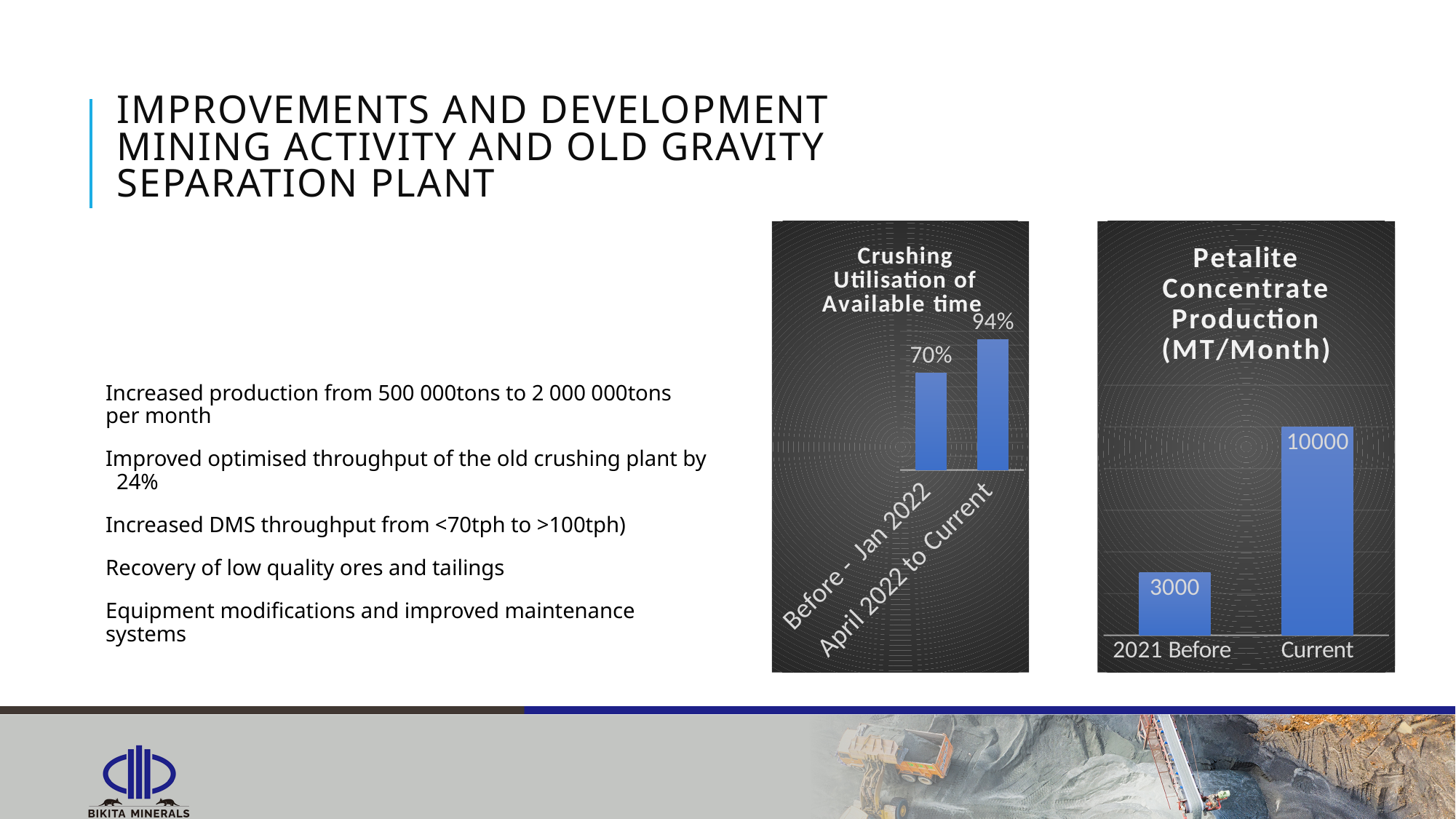
In the 'Petalite Concentrate Production (MT/Month)' chart, what is the difference between the 'Current' and '2021 Before' values? 7000 In the 'Petalite Concentrate Production (MT/Month)' chart, is the value for 'Current' larger or smaller than the value for '2021 Before'? larger What kind of chart is the 'Petalite Concentrate Production (MT/Month)' chart? bar chart In the 'Crushing Utilisation of Available time' chart, what is the value for 'April 2022 to Current'? 94% In the 'Crushing Utilisation of Available time' chart, which category has the higher value? April 2022 to Current In the 'Petalite Concentrate Production (MT/Month)' chart, which category has the lowest value? 2021 Before In the 'Crushing Utilisation of Available time' chart, what is the difference between the 'April 2022 to Current' and 'Before - Jan 2022' values? 24% In the 'Crushing Utilisation of Available time' chart, do the values rise or fall from left to right? rise In the 'Crushing Utilisation of Available time' chart, how many bars are plotted? 2 In the 'Petalite Concentrate Production (MT/Month)' chart, what is the value for '2021 Before'? 3000 In the 'Petalite Concentrate Production (MT/Month)' chart, what is the value for 'Current'? 10000 In the 'Crushing Utilisation of Available time' chart, what is the value for 'Before - Jan 2022'? 70%